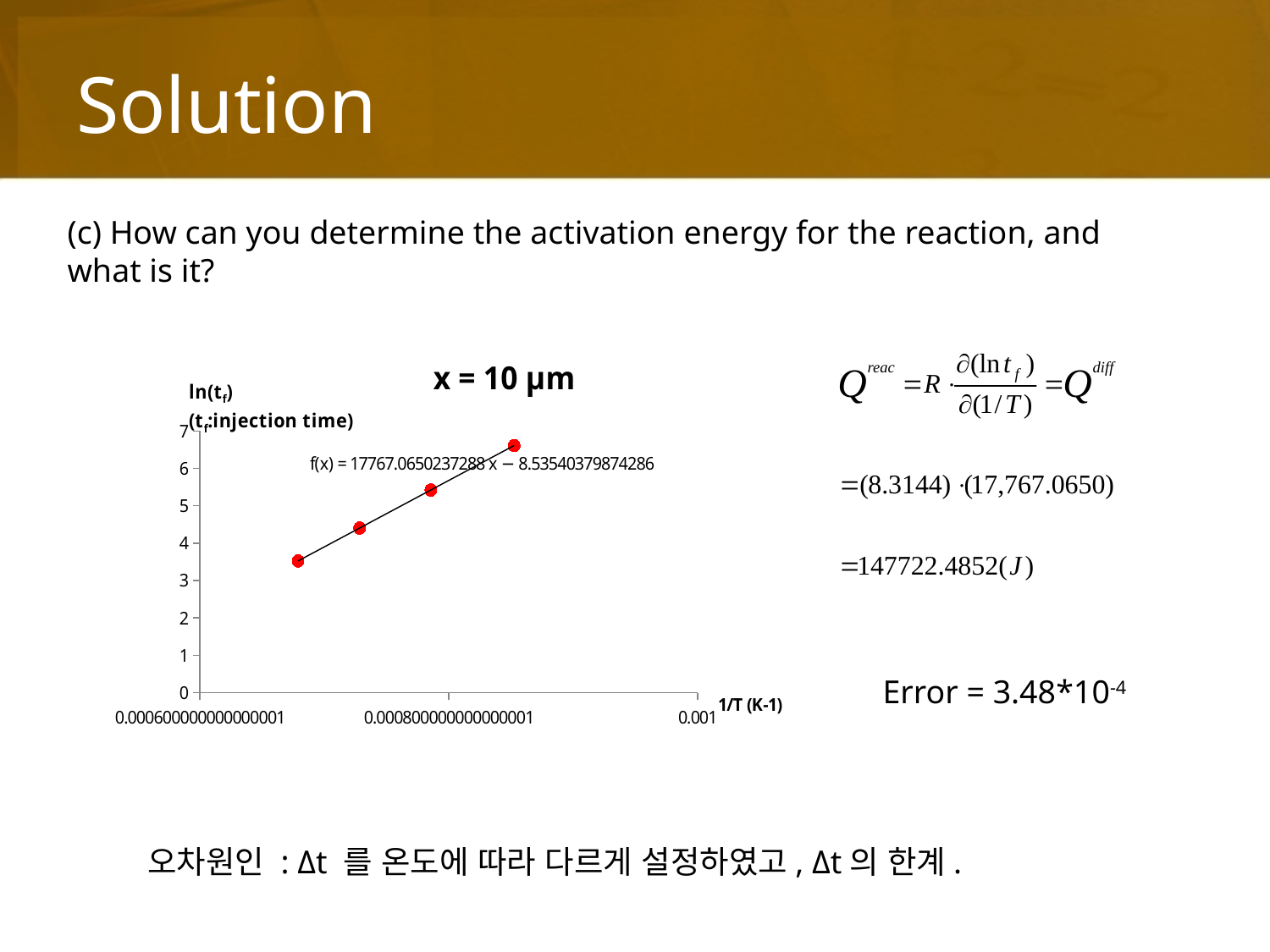
Which data point has the highest ln(t_f) value? the point at the largest 1/T (rightmost point) Do the plotted ln(t_f) values rise or fall as 1/T increases along the x axis? rise What is the intercept of the fitted trendline shown in the chart's equation? −8.53540379874286 What is the slope of the fitted trendline shown in the chart's equation? 17767.0650237288 How many data points are plotted on the chart? 4 Is the ln(t_f) value of the third data point from the left greater or less than 5? greater Is the ln(t_f) value of the lowest data point greater or less than 4? less Is the ln(t_f) value of the highest data point greater or less than 6? greater What is the title of the chart? x = 10 μm Which has the larger ln(t_f) value, the leftmost data point or the rightmost data point? the rightmost data point What kind of chart is shown on the slide? scatter chart with a trendline What is the label of the y axis of the chart? ln(t_f)